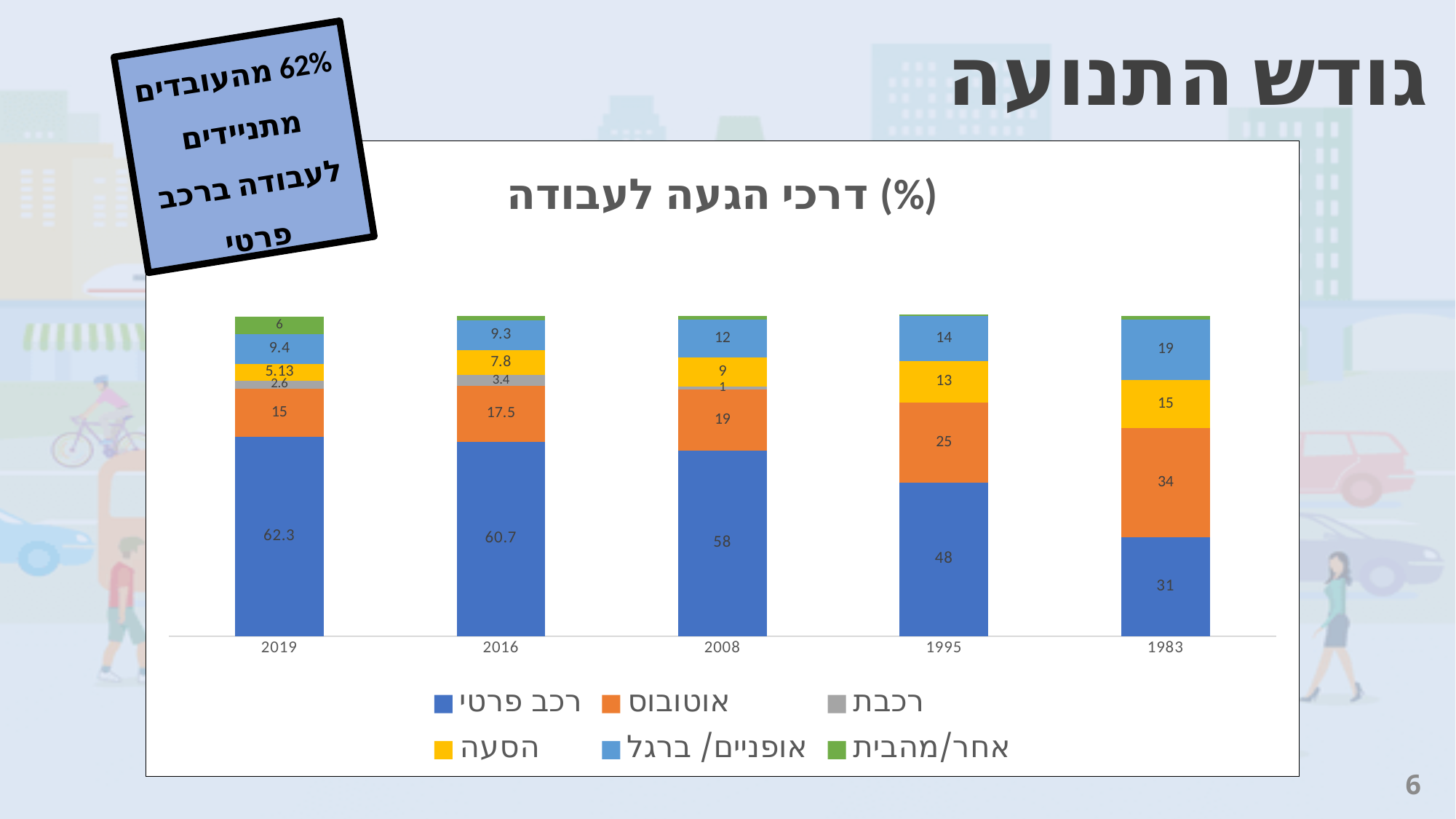
Moving left to right along the x axis from 2019 to 1983, does the רכב פרטי (private car) value rise or fall? fall What is the value for רכבת (train) in 2016? 3.4 In 2008, which is larger: the רכב פרטי (private car) value or the אוטובוס (bus) value? רכב פרטי What kind of chart is shown on the slide? stacked bar chart What is the difference between the אוטובוס (bus) value in 1983 and in 2019? 19 How many series does the legend list? 6 In which year is the רכב פרטי (private car) value the lowest? 1983 How many years are shown on the x axis? 5 What is the value for אופניים/ברגל (bicycle/walking) in 2008? 12 What is the value for רכב פרטי (private car) in 2019? 62.3 In which year is the רכב פרטי (private car) value the highest? 2019 What is the value for אוטובוס (bus) in 1983? 34